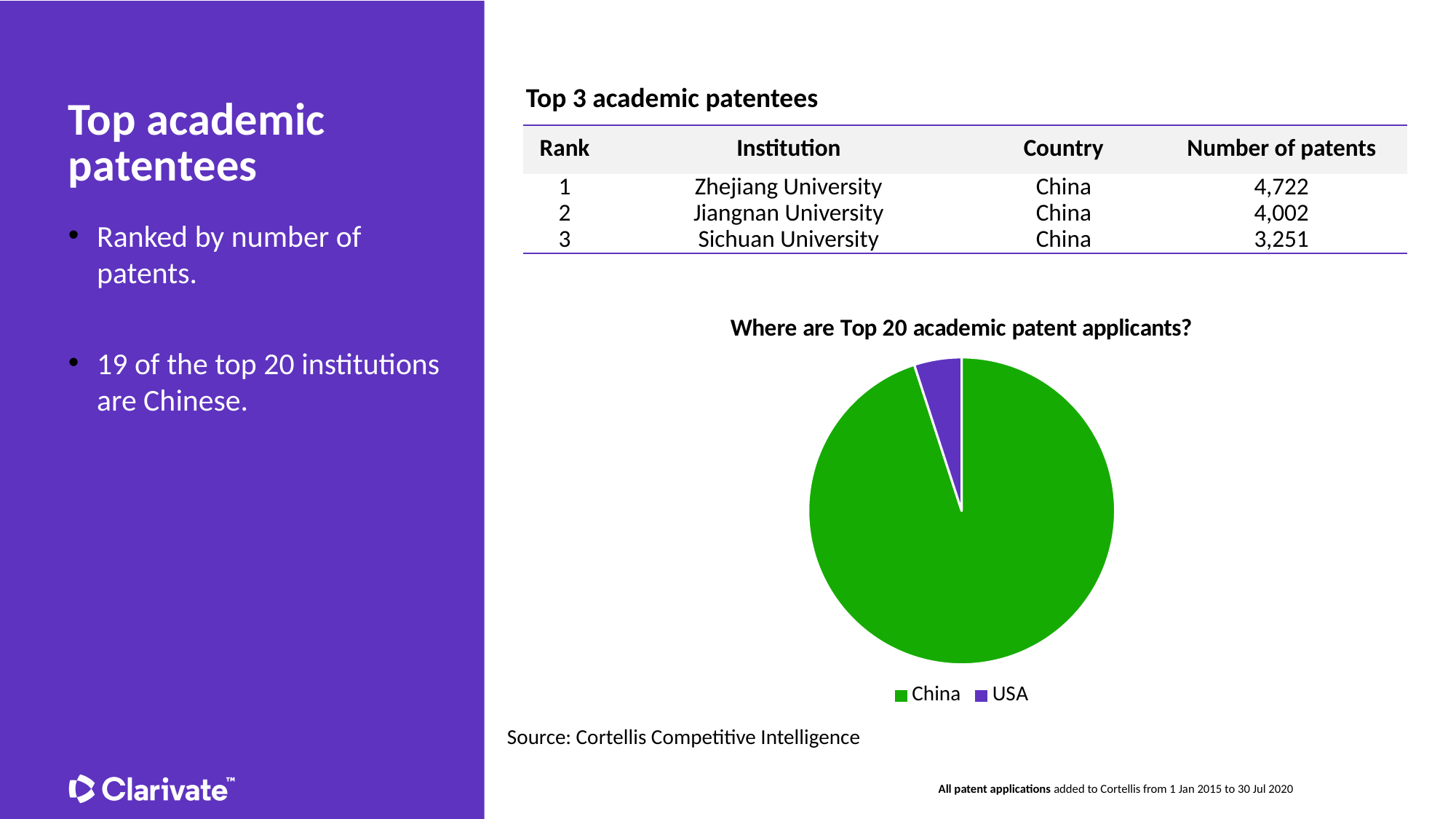
How many slices does the pie chart have? 2 How many entries does the pie chart's legend list? 2 In the pie chart, which slice is larger, China or USA? China What is the title of the pie chart? Where are Top 20 academic patent applicants? What kind of chart is shown under the title "Where are Top 20 academic patent applicants?"? pie chart What colour is the USA slice in the pie chart? purple Which category has the largest slice in the pie chart? China Which category has the smallest slice in the pie chart? USA